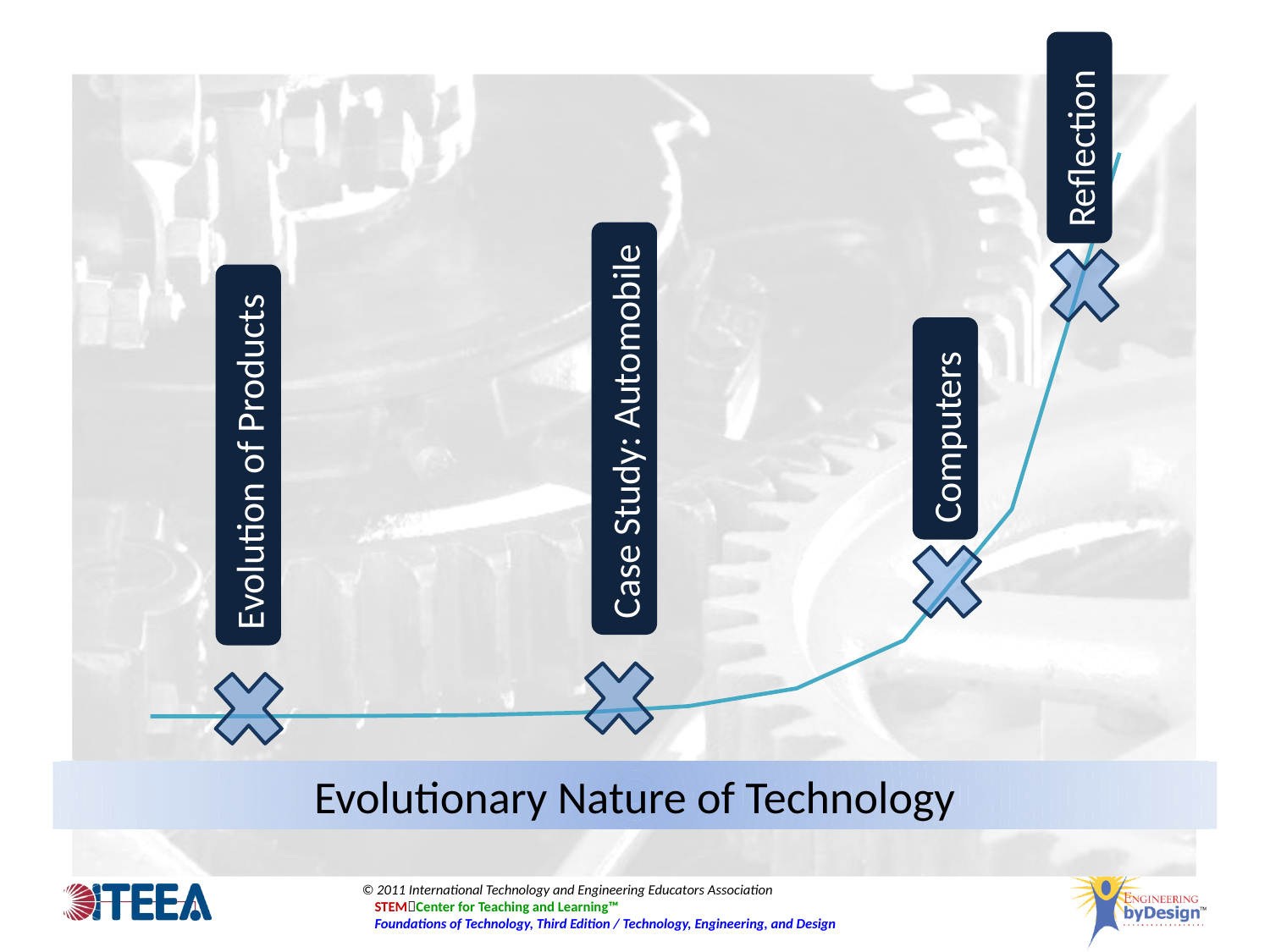
What is the title shown beneath the chart? Evolutionary Nature of Technology Do the values rise or fall along the x axis from left to right? rise Which marked point is highest on the line? Reflection Which is higher on the line, Reflection or Computers? Reflection What shape is used to mark the points on the line? an X What kind of chart is shown on the slide? line chart What is the label of the third marked point from the left? Computers What is the label of the first marked point on the left of the line? Evolution of Products How many marked points are there on the line? 4 Which is higher on the line, Computers or Case Study: Automobile? Computers Which marked point is lowest on the line? Evolution of Products What is the label of the second marked point from the left? Case Study: Automobile